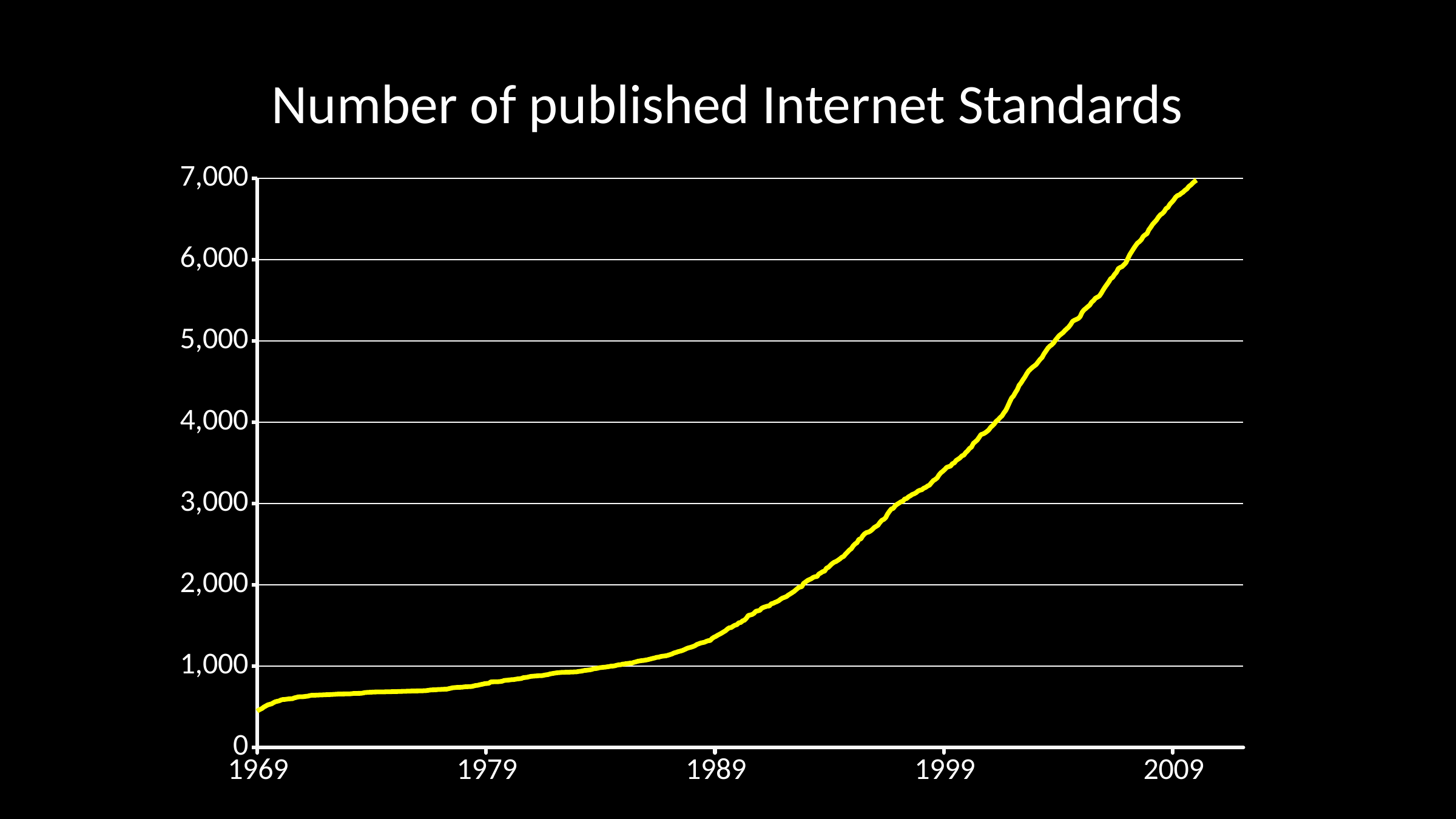
Is the value for 1989 greater or less than 1,000? greater Do the values rise or fall from 1969 to 2009? rise What kind of chart is shown on the slide? line chart What is the first year labelled on the horizontal axis? 1969 What is the highest value shown on the vertical axis? 7,000 Is the value for 2009 greater or less than 6,000? greater Which year has the higher value, 1979 or 1999? 1999 What is the title of the chart? Number of published Internet Standards Is the value for 1979 greater or less than 1,000? less